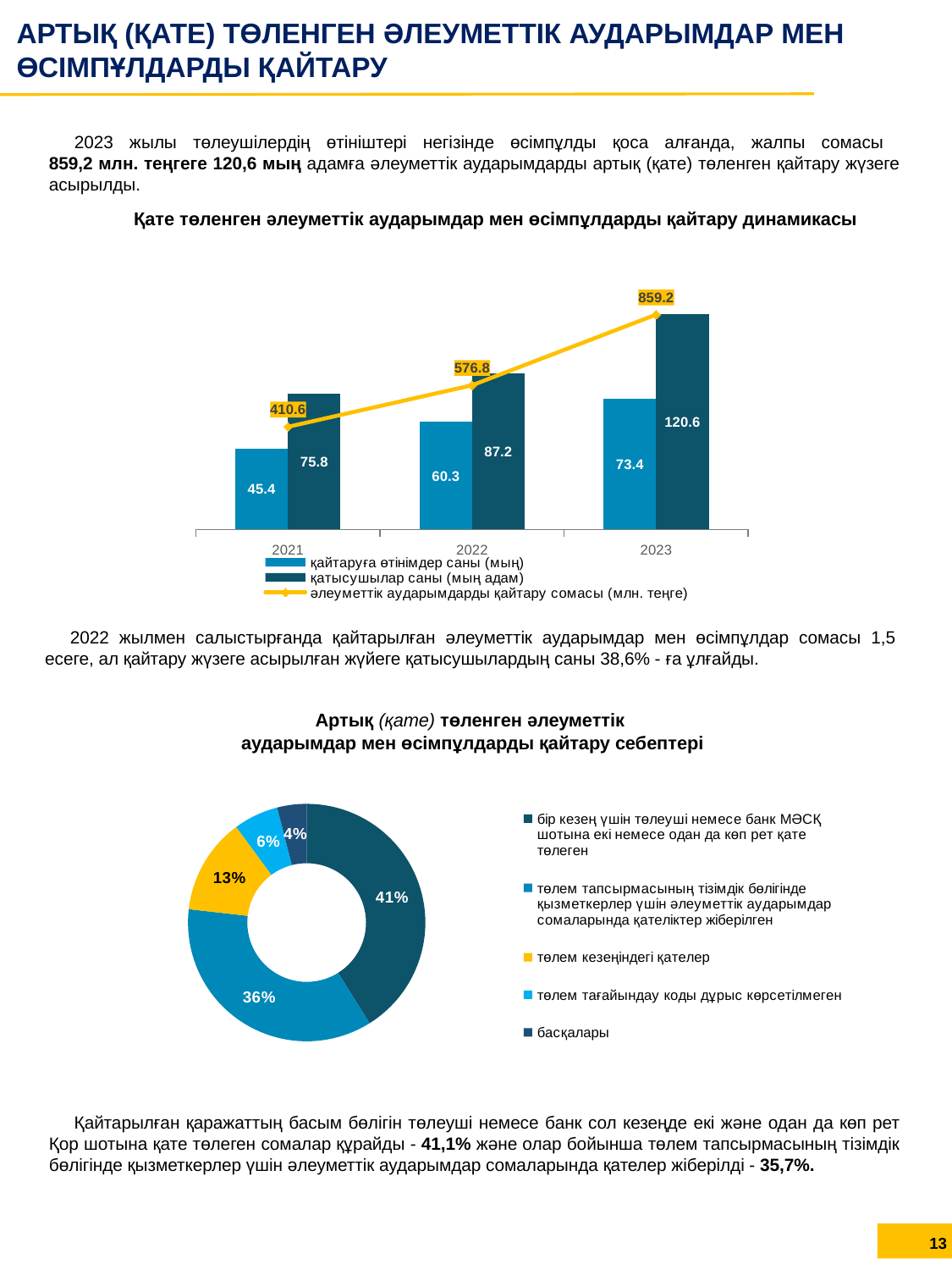
In the chart titled "Артық (қате) төленген әлеуметтік аударымдар мен өсімпұлдарды қайтару себептері", how many categories does the legend list? 5 In the chart titled "Артық (қате) төленген әлеуметтік аударымдар мен өсімпұлдарды қайтару себептері", which category has the smallest share? басқалары In the chart titled "Қате төленген әлеуметтік аударымдар мен өсімпұлдарды қайтару динамикасы", what is the value of "әлеуметтік аударымдарды қайтару сомасы (млн. теңге)" for 2022? 576.8 In the chart titled "Артық (қате) төленген әлеуметтік аударымдар мен өсімпұлдарды қайтару себептері", what share does "төлем кезеңіндегі қателер" have? 13% In the chart titled "Қате төленген әлеуметтік аударымдар мен өсімпұлдарды қайтару динамикасы", how many series does the legend list? 3 In the chart titled "Артық (қате) төленген әлеуметтік аударымдар мен өсімпұлдарды қайтару себептері", what kind of chart is shown? doughnut chart In the chart titled "Қате төленген әлеуметтік аударымдар мен өсімпұлдарды қайтару динамикасы", does the "әлеуметтік аударымдарды қайтару сомасы (млн. теңге)" line rise or fall from 2021 to 2023? rise In the chart titled "Қате төленген әлеуметтік аударымдар мен өсімпұлдарды қайтару динамикасы", what is the value of "қатысушылар саны (мың адам)" for 2023? 120.6 In the chart titled "Қате төленген әлеуметтік аударымдар мен өсімпұлдарды қайтару динамикасы", what is the value of "қайтаруға өтінімдер саны (мың)" for 2021? 45.4 In the chart titled "Қате төленген әлеуметтік аударымдар мен өсімпұлдарды қайтару динамикасы", how many years are shown on the x axis? 3 In the chart titled "Қате төленген әлеуметтік аударымдар мен өсімпұлдарды қайтару динамикасы", what is the difference between the "қатысушылар саны (мың адам)" values for 2023 and 2022? 33.4 In the chart titled "Қате төленген әлеуметтік аударымдар мен өсімпұлдарды қайтару динамикасы", which year has the highest value of "әлеуметтік аударымдарды қайтару сомасы (млн. теңге)"? 2023